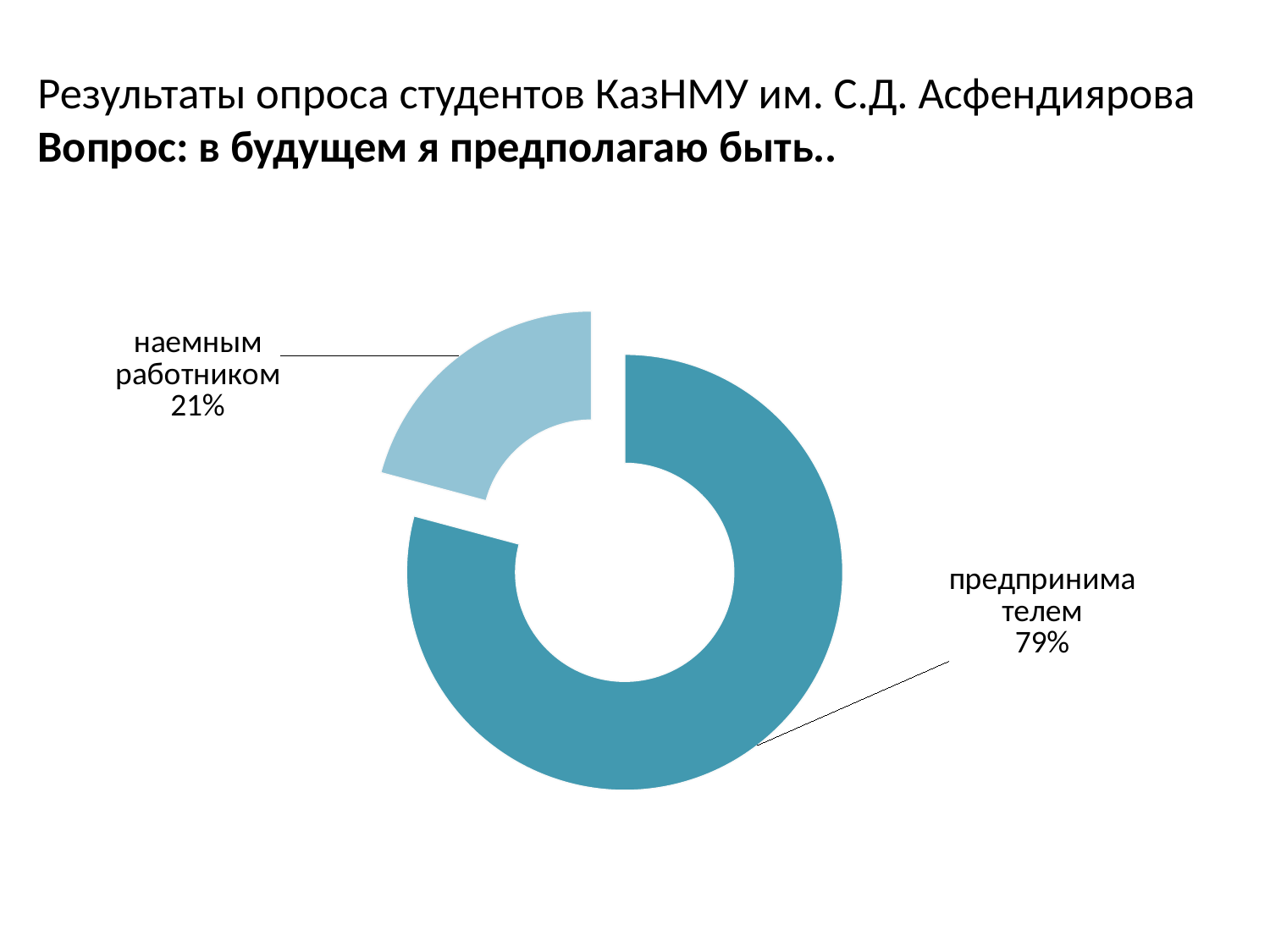
What is the total of the two shares shown in the chart? 100% Which category has the largest share? предпринимателем What is the difference in percentage points between "предпринимателем" and "наемным работником"? 58 Which is larger: the share for "предпринимателем" or for "наемным работником"? предпринимателем What kind of chart is shown on the slide? Doughnut (pie) chart What share of respondents chose "наемным работником"? 21% What survey question does the chart present, according to the slide title? в будущем я предполагаю быть.. What share of respondents chose "предпринимателем"? 79% Which category is shown in the lighter blue colour? наемным работником Which category has the smallest share? наемным работником How many categories are shown in the chart? 2